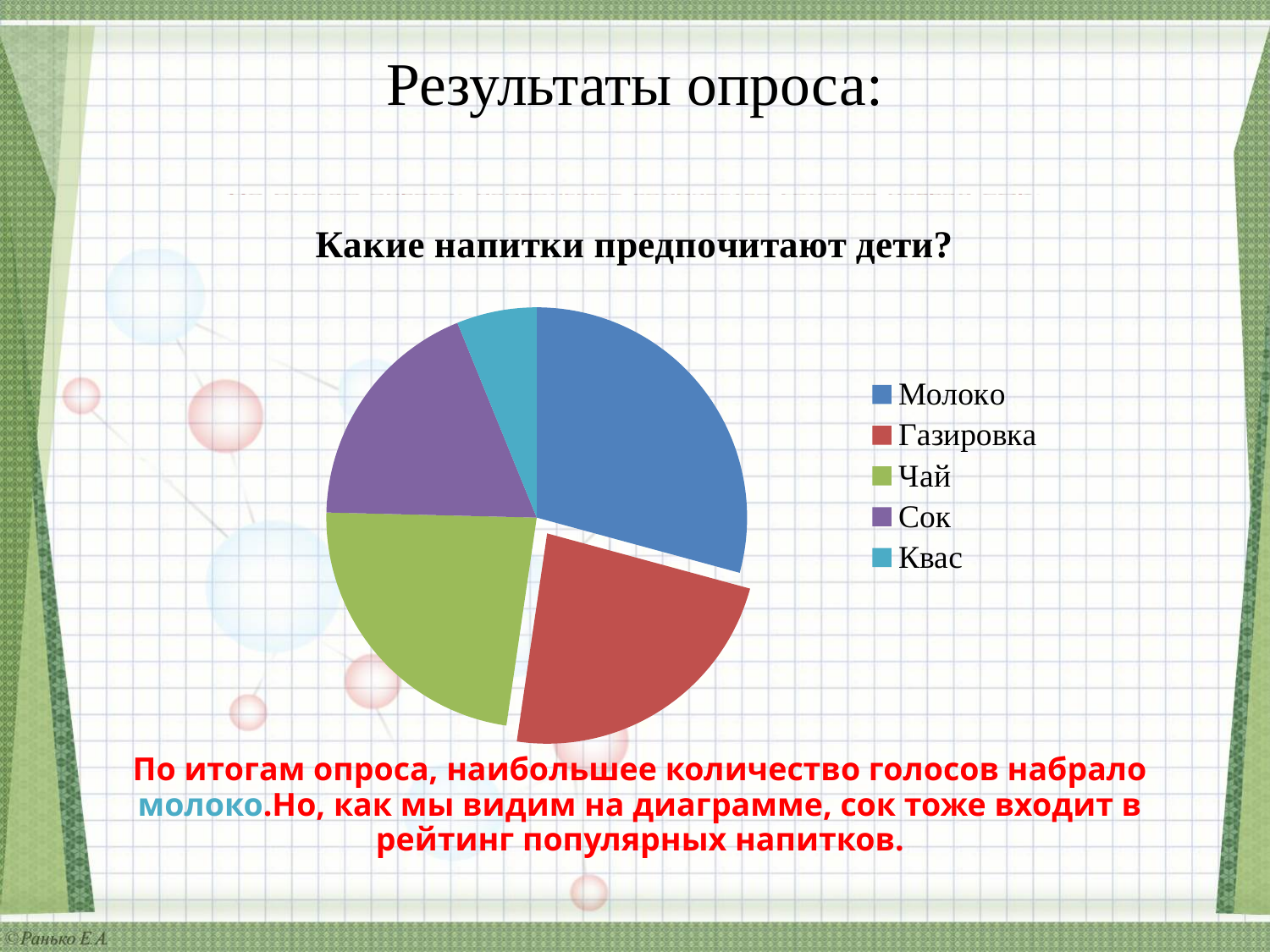
Which slice is larger, Молоко or Сок? Молоко Which drink has the largest slice of the pie? Молоко How many categories (slices) does the pie chart have? 5 Which slice is larger, Квас or Чай? Чай Which category is shown in blue in the legend? Молоко Which slice is larger, Сок or Квас? Сок What kind of chart is shown on the slide? pie chart What is the title of the chart? Какие напитки предпочитают дети? Which drink has the smallest slice of the pie? Квас